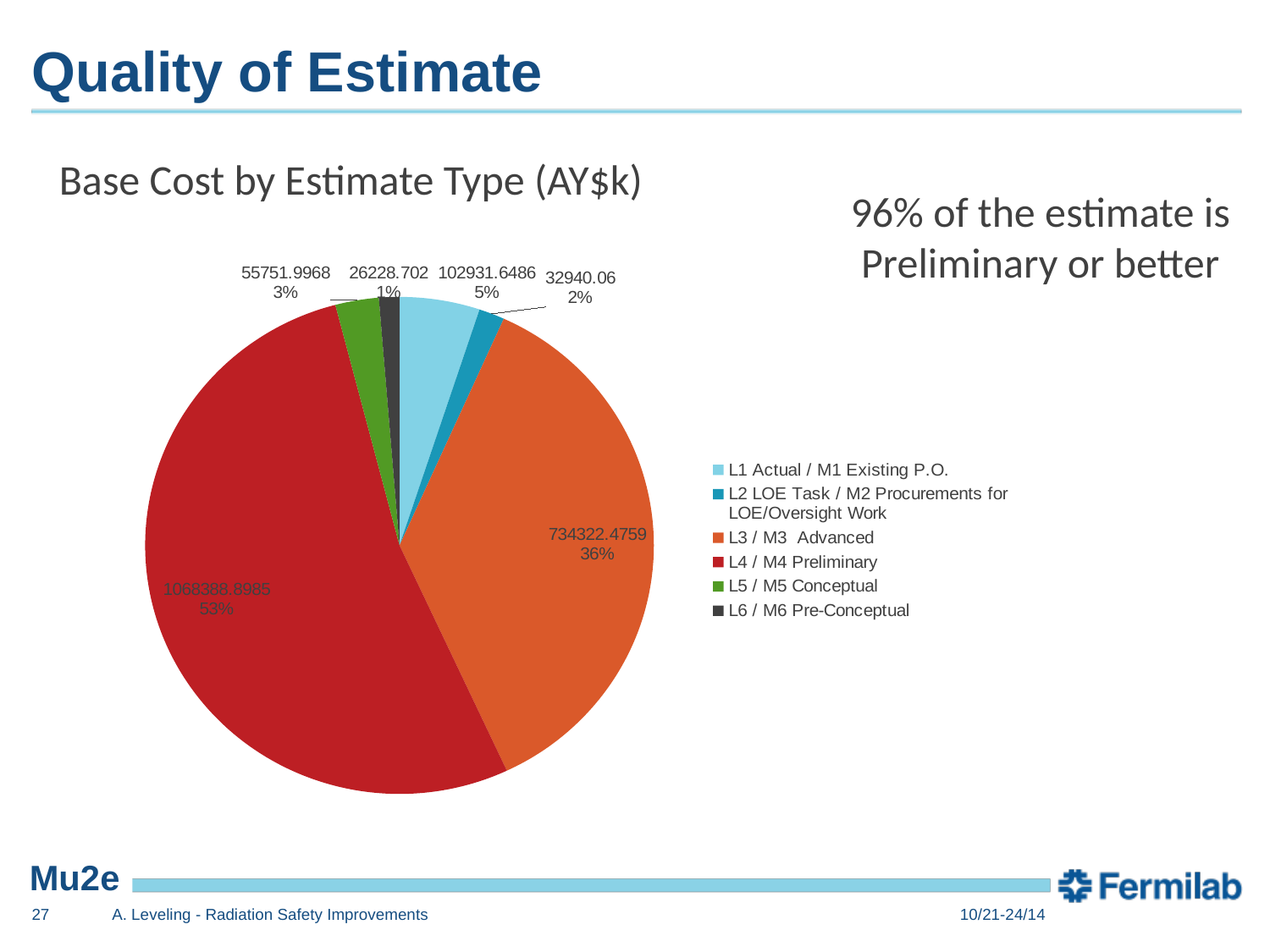
How many slices does the pie chart have? 6 How many entries does the legend list? 6 What is the title of the chart? Base Cost by Estimate Type (AY$k) What is the value for L3 / M3 Advanced? 734322.4759 What share of the pie is L3 / M3 Advanced? 36% Which is larger, the share for L5 / M5 Conceptual or the share for L2 LOE Task / M2 Procurements for LOE/Oversight Work? L5 / M5 Conceptual What type of chart is shown on the slide? pie chart What share of the pie is L4 / M4 Preliminary? 53% Which estimate type has the smallest slice of the pie? L6 / M6 Pre-Conceptual What is the value for L1 Actual / M1 Existing P.O.? 102931.6486 Which estimate type has the largest slice of the pie? L4 / M4 Preliminary What is the value for L4 / M4 Preliminary? 1068388.8985